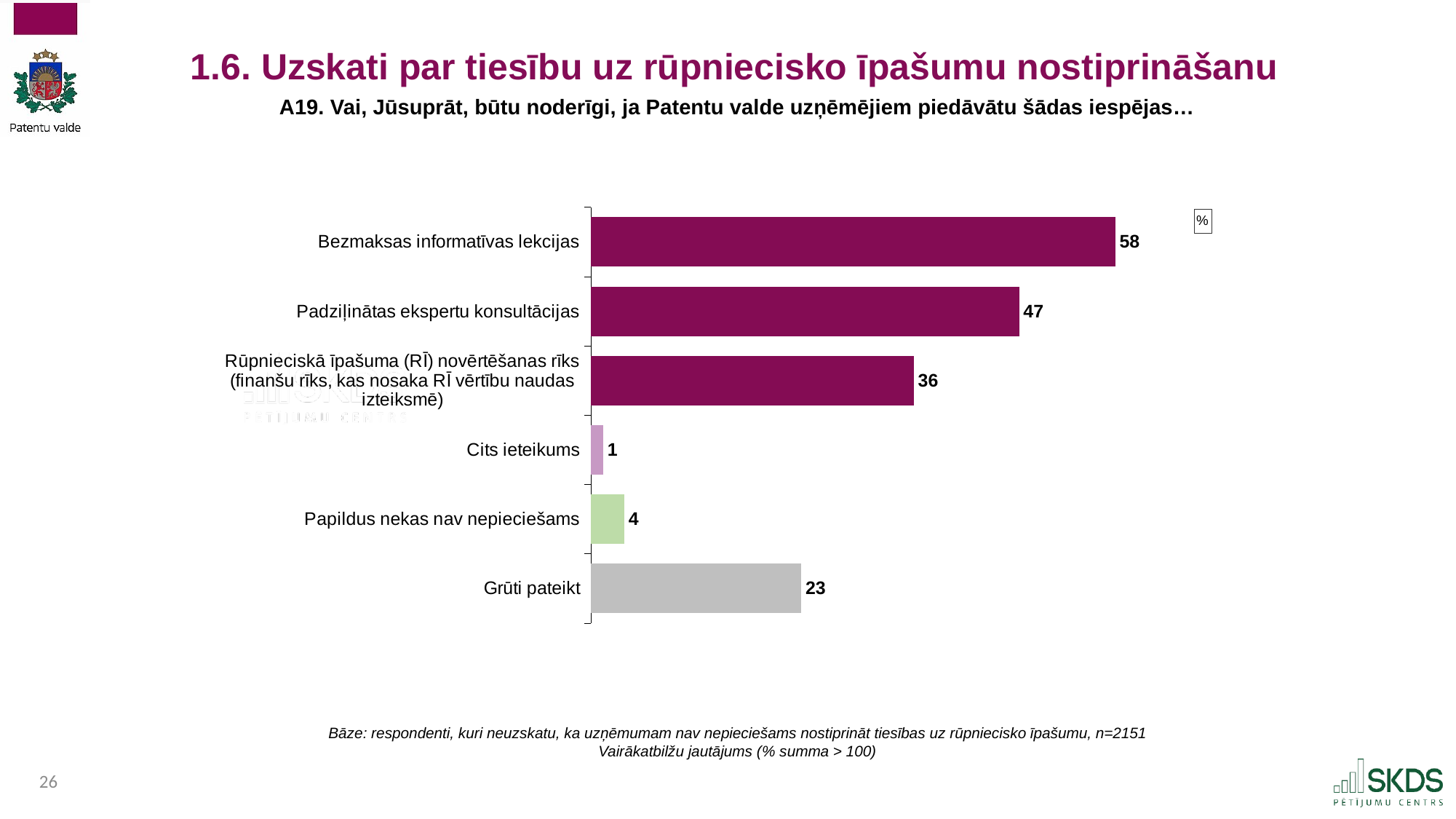
What is the difference between the values for "Grūti pateikt" and "Papildus nekas nav nepieciešams"? 19 What kind of chart is shown on the slide? Bar chart What is the sample size (n) stated in the base note below the chart? n=2151 What is the value for "Grūti pateikt"? 23 What is the value for "Papildus nekas nav nepieciešams"? 4 Which is larger: the value for "Rūpnieciskā īpašuma (RĪ) novērtēšanas rīks" or the value for "Grūti pateikt"? Rūpnieciskā īpašuma (RĪ) novērtēšanas rīks What is the difference between the values for "Bezmaksas informatīvas lekcijas" and "Padziļinātas ekspertu konsultācijas"? 11 How many categories are shown in the chart? 6 What is the value for "Padziļinātas ekspertu konsultācijas"? 47 What is the value for "Bezmaksas informatīvas lekcijas"? 58 Which category has the highest value? Bezmaksas informatīvas lekcijas Which category has the lowest value? Cits ieteikums